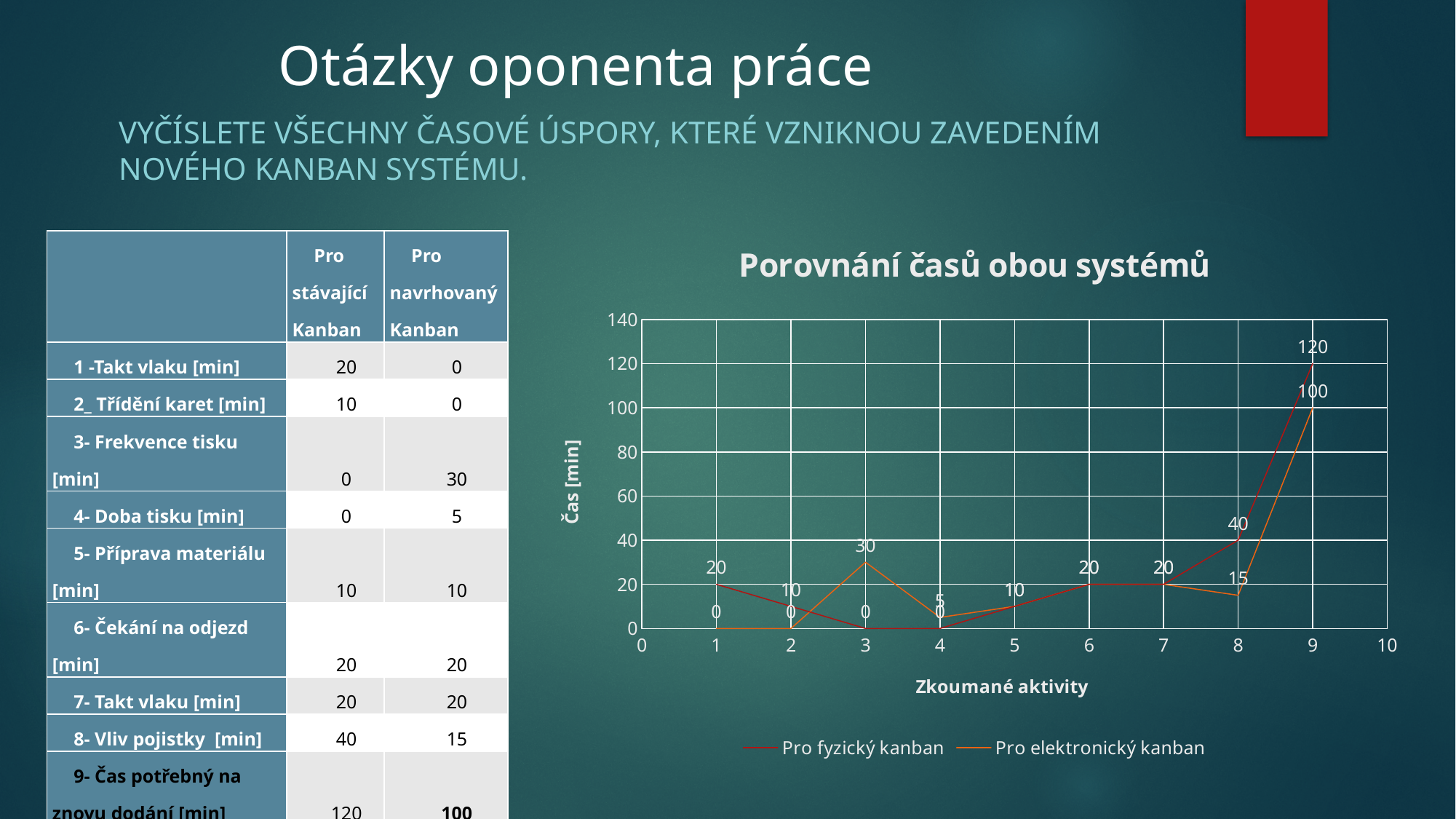
What is the value for Pro elektronický kanban at activity 8? 15 Which series has the larger value at activity 3, Pro fyzický kanban or Pro elektronický kanban? Pro elektronický kanban What type of chart is shown on the slide? line chart What is the value for Pro fyzický kanban at activity 9? 120 What is the value for Pro elektronický kanban at activity 9? 100 What is the value for Pro elektronický kanban at activity 3? 30 What is the difference between Pro fyzický kanban and Pro elektronický kanban at activity 8? 25 What is the title of the chart? Porovnání časů obou systémů At which activity does Pro fyzický kanban reach its highest value? 9 What is the value for Pro fyzický kanban at activity 8? 40 How many series does the chart legend list? 2 What is the label of the y axis? Čas [min]